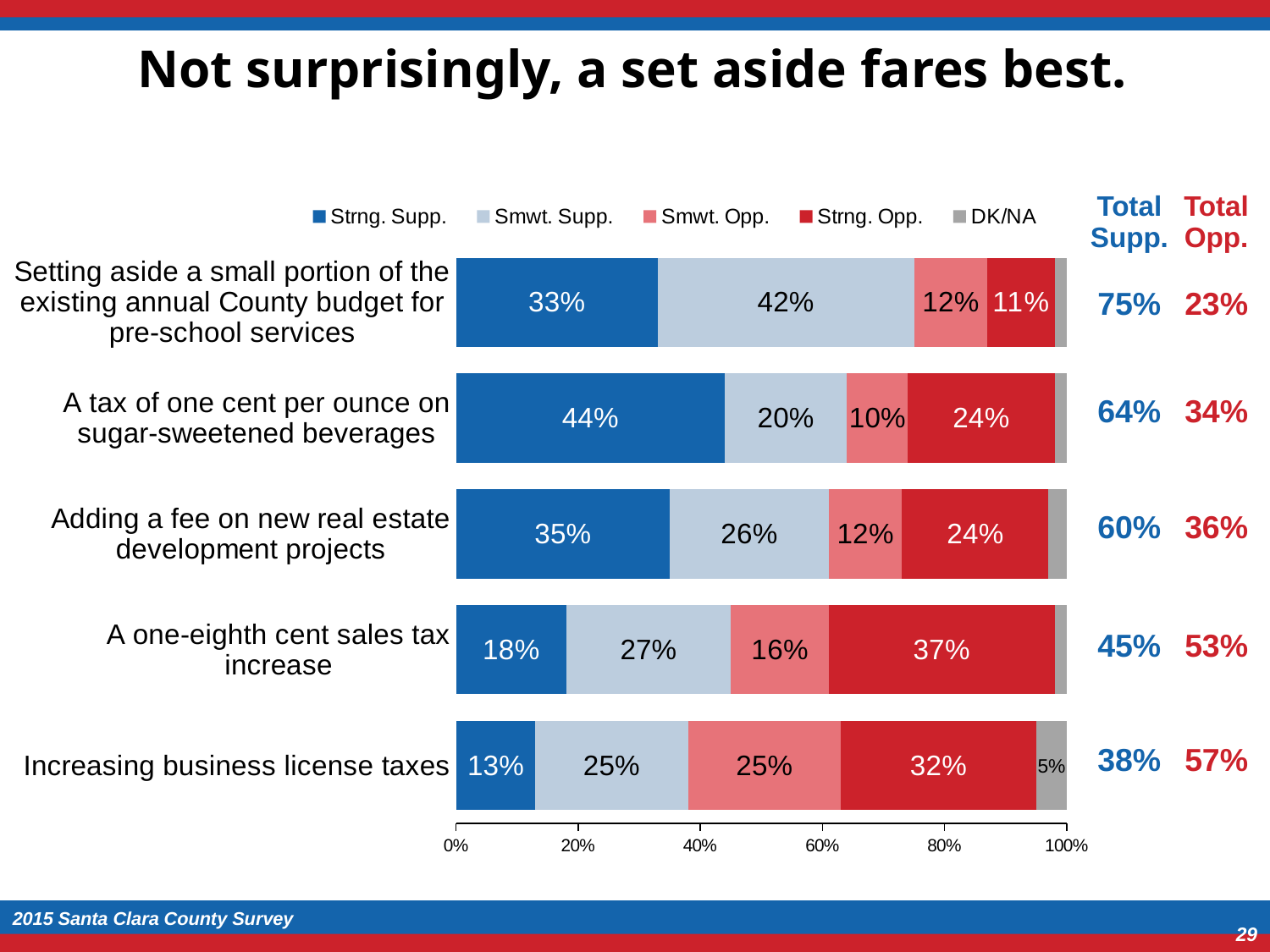
Which proposal has the highest Strng. Supp. value? A tax of one cent per ounce on sugar-sweetened beverages How many series does the legend list? 5 What percentage strongly oppose a one-eighth cent sales tax increase? 37% What is the DK/NA value for increasing business license taxes? 5% Which proposal has the lowest Strng. Supp. value? Increasing business license taxes What kind of chart is shown on the slide? Stacked bar chart Which has a larger Strng. Supp. value: adding a fee on new real estate development projects or setting aside a small portion of the existing annual County budget for pre-school services? Adding a fee on new real estate development projects What is the combined Strng. Supp. and Smwt. Supp. share for a one-eighth cent sales tax increase? 45% What percentage strongly support a tax of one cent per ounce on sugar-sweetened beverages? 44% What percentage somewhat support setting aside a small portion of the existing annual County budget for pre-school services? 42% For increasing business license taxes, how many percentage points higher is Strng. Opp. than Strng. Supp.? 19 percentage points How many proposals are shown in the chart? 5